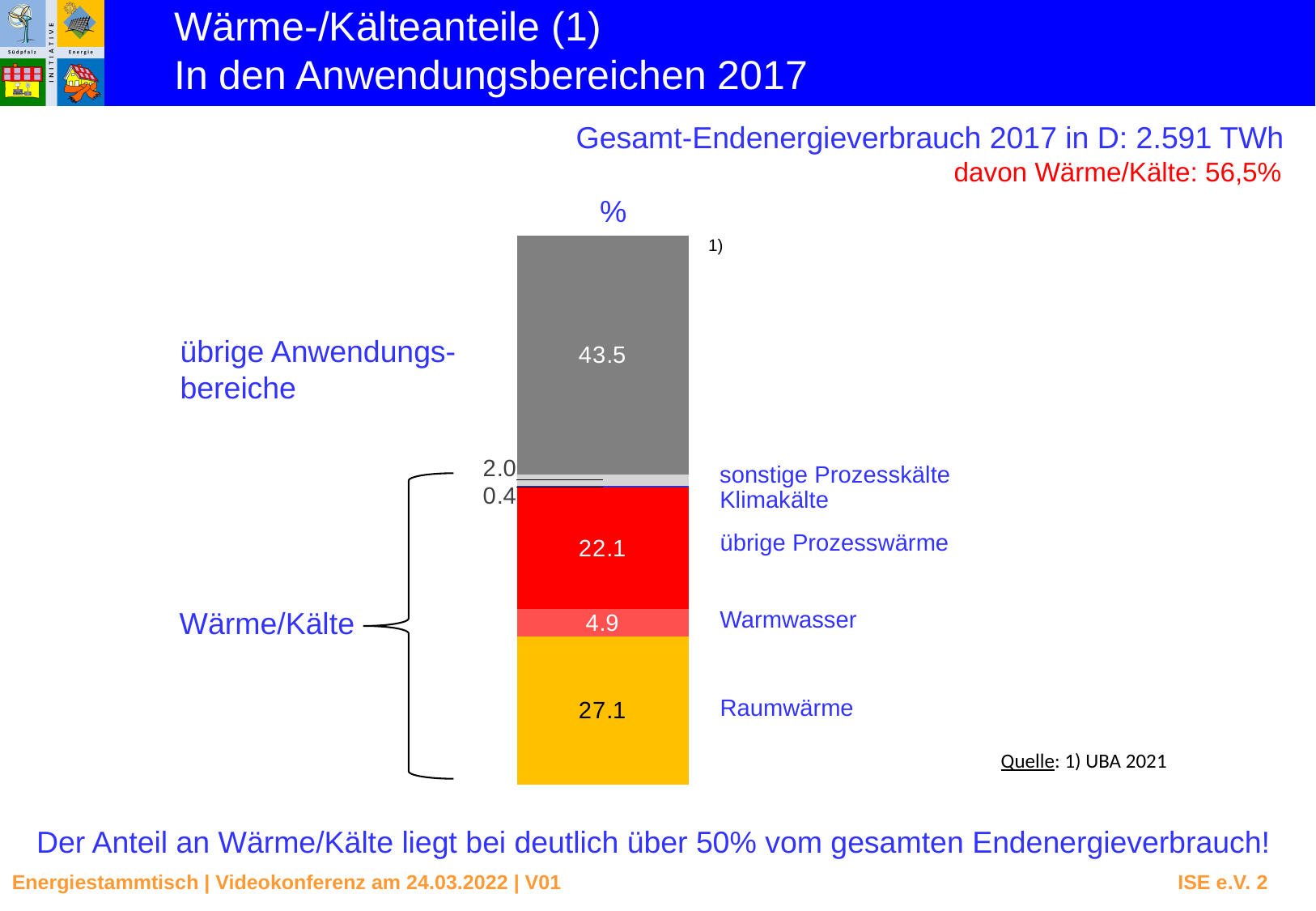
What is the value for übrige Anwendungsbereiche? 43.5 What is the value for Klimakälte? 0.4 What is the value for übrige Prozesswärme? 22.1 Which segment of the stacked bar has the largest value? übrige Anwendungsbereiche Which is larger, Raumwärme or übrige Prozesswärme? Raumwärme What kind of chart is shown on the slide? stacked bar chart What is the total of the segments grouped under Wärme/Kälte (sonstige Prozesskälte, Klimakälte, übrige Prozesswärme, Warmwasser, Raumwärme)? 56.5 Which segment of the stacked bar has the smallest value? Klimakälte What is the value for Warmwasser in the stacked bar? 4.9 What is the value for Raumwärme in the stacked bar? 27.1 How many segments does the stacked bar contain? 6 What is the difference between the values for Raumwärme and Warmwasser? 22.2